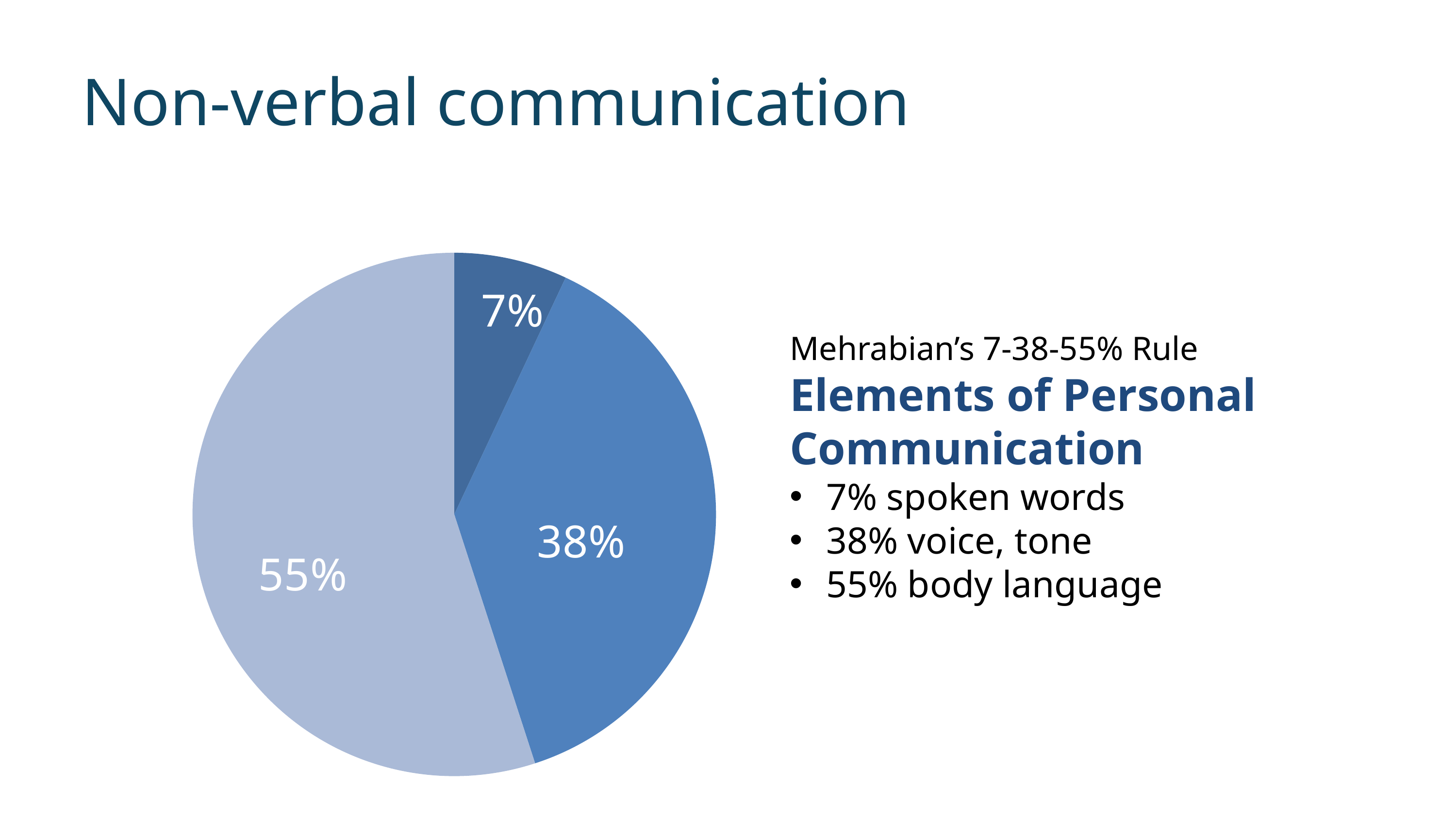
What share of the pie does the smallest slice represent? 7% What rule is named in the text next to the pie chart? Mehrabian's 7-38-55% Rule Which is larger in the pie chart, the slice for voice and tone or the slice for spoken words? voice, tone What kind of chart is shown on the slide? pie chart According to the slide, what percentage is attributed to spoken words? 7% Which element of personal communication has the largest slice in the pie chart? body language What is the difference between the 55% slice and the 38% slice? 17% Which element of personal communication has the smallest slice in the pie chart? spoken words How many slices does the pie chart have? 3 According to the slide, what percentage is attributed to voice and tone? 38% According to the slide, what percentage is attributed to body language? 55% What share of the pie does the largest slice represent? 55%